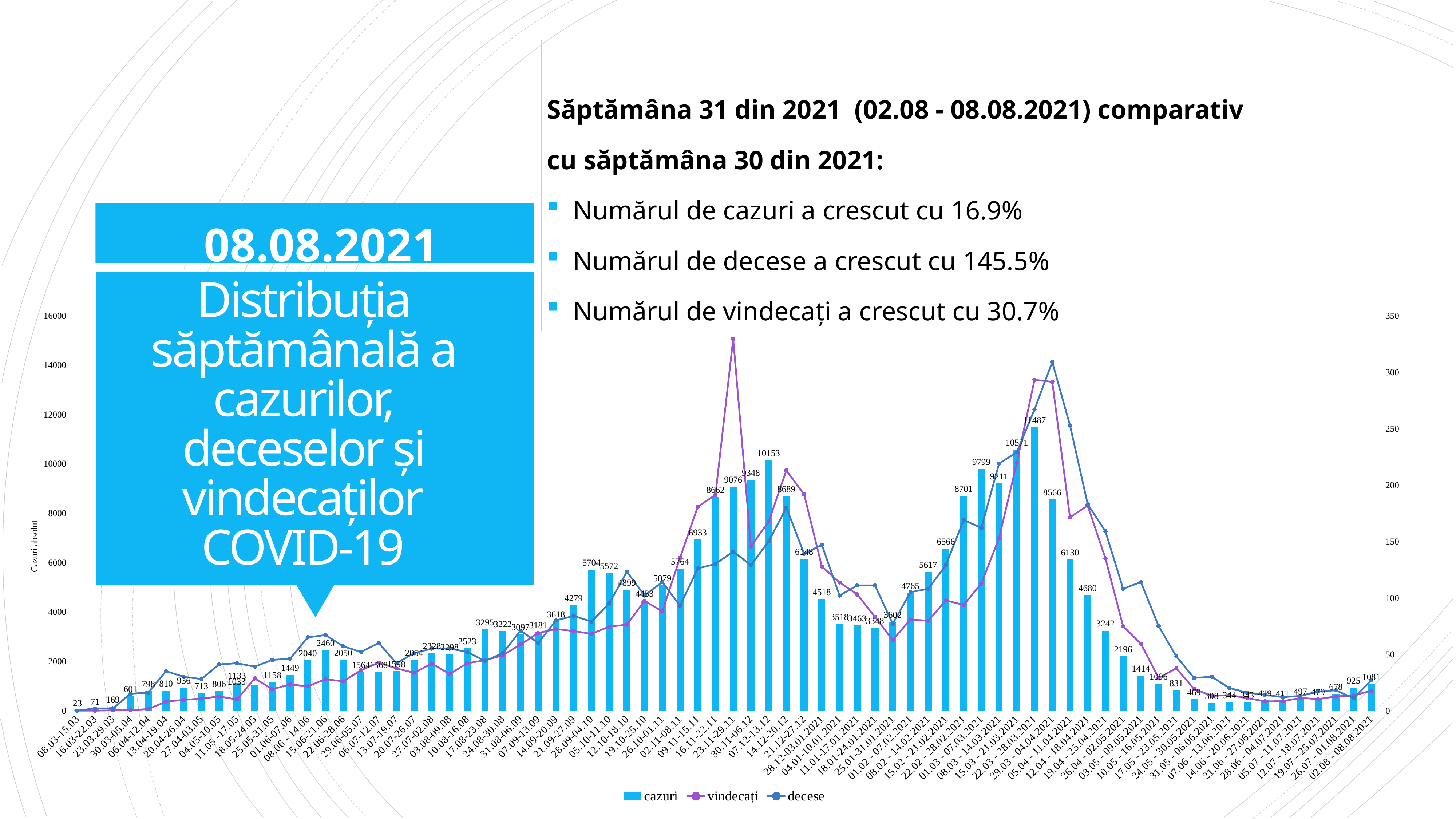
Which series are listed in the chart legend? cazuri, vindecați, decese What is the value of cazuri for the first week shown, 08.03-15.03? 23 Do the cazuri bars rise or fall from the week 22.03 - 28.03.2021 to the week 31.05 - 06.06.2021? Fall Which week has the lowest number of cazuri? 08.03-15.03 What is the value of cazuri for the week 26.07 - 01.08.2021? 925 What is the value of cazuri for the week 22.03 - 28.03.2021? 11487 How many series does the chart legend list? 3 What is the value of cazuri for the week 02.08 - 08.08.2021? 1081 What kind of chart is shown on the slide? Combined bar and line chart What is the difference in cazuri between the week 02.08 - 08.08.2021 and the week 26.07 - 01.08.2021? 156 Which week has more cazuri: 07.12-13.12 or 22.03 - 28.03.2021? 22.03 - 28.03.2021 Which week has the highest number of cazuri? 22.03 - 28.03.2021